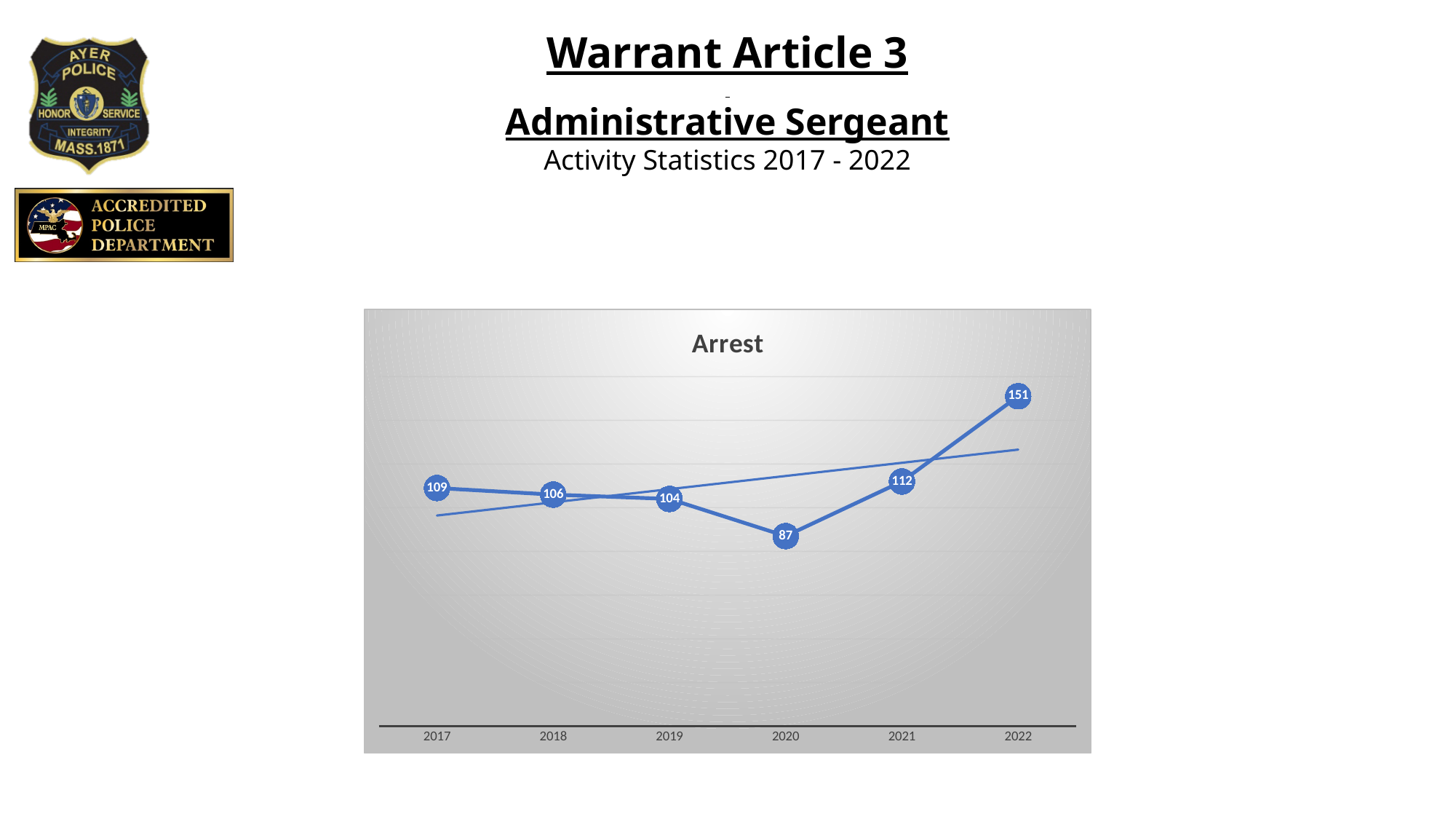
Which year has the highest Arrest value? 2022 What is the Arrest value for 2017? 109 What is the Arrest value for 2020? 87 What is the Arrest value for 2019? 104 Which year has the lowest Arrest value? 2020 What is the title of the chart? Arrest What kind of chart is the Arrest chart? line chart What is the Arrest value for 2022? 151 What is the difference between the Arrest values for 2022 and 2021? 39 What is the difference between the Arrest values for 2017 and 2020? 22 How many years are plotted on the Arrest chart? 6 Which year has a larger Arrest value, 2018 or 2021? 2021